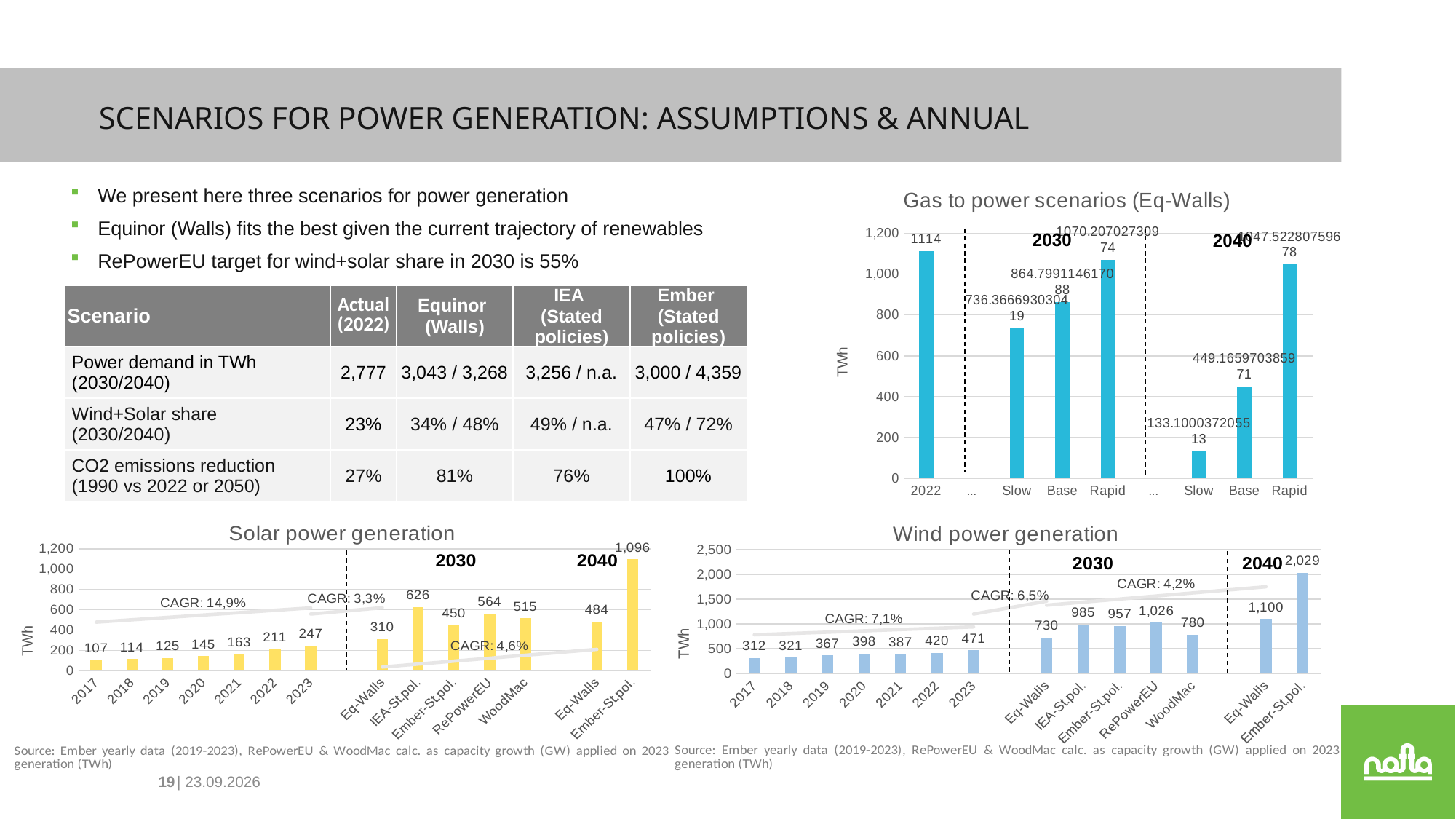
In the Wind power generation chart, which is larger: the 2030 IEA-St.pol. value or the 2030 Ember-St.pol. value? IEA-St.pol. In the Gas to power scenarios (Eq-Walls) chart, what is the value for 2022? 1114 In the Wind power generation chart, what is the value for the 2030 RePowerEU scenario? 1,026 In the Wind power generation chart, what is the difference between the 2021 value and the 2020 value? 11 In the Solar power generation chart, which 2030 scenario has the highest value? IEA-St.pol. In the Gas to power scenarios (Eq-Walls) chart, which 2040 scenario has the highest value? Rapid What kind of chart is the Wind power generation chart? bar chart In the Solar power generation chart, what is the value for 2023? 247 In the Solar power generation chart, what is the difference between the 2040 Ember-St.pol. value and the 2040 Eq-Walls value? 612 In the Gas to power scenarios (Eq-Walls) chart, is the value for the 2040 Slow scenario greater or less than 200? less In the Wind power generation chart, which 2030 scenario has the lowest value? Eq-Walls In the Solar power generation chart, do the values rise or fall from 2017 to 2023? rise